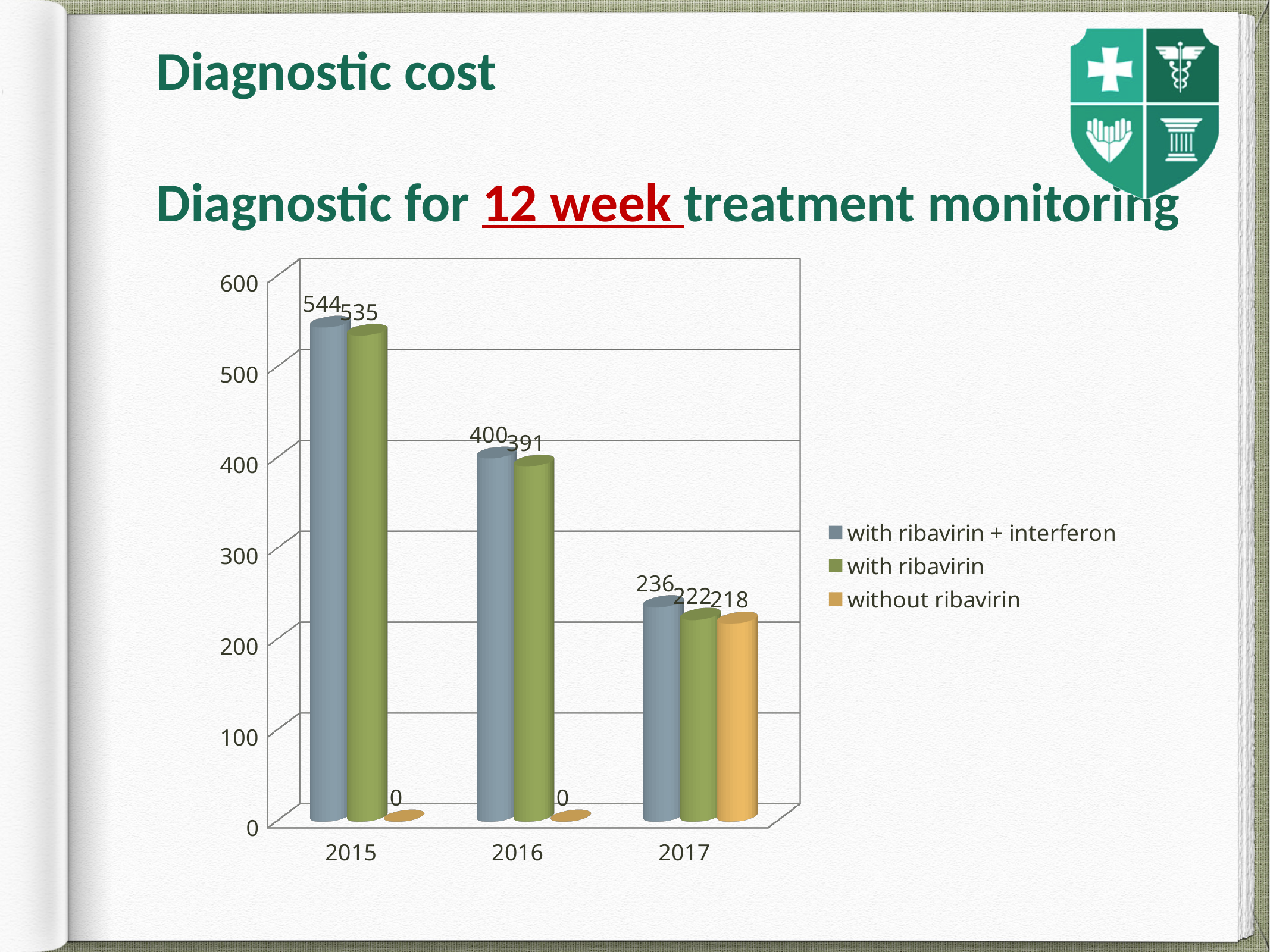
What is the value for 'with ribavirin' in 2016? 391 What is the value for 'without ribavirin' in 2015? 0 In which year is the value for 'with ribavirin' lowest? 2017 What is the difference between 'with ribavirin + interferon' and 'with ribavirin' in 2016? 9 How many series does the legend list? 3 How many years are shown on the x axis? 3 What kind of chart is shown on the slide? bar chart What is the value for 'with ribavirin + interferon' in 2015? 544 Do the values for 'with ribavirin' rise or fall from 2015 to 2017? fall Which is larger in 2017: 'with ribavirin + interferon' or 'without ribavirin'? with ribavirin + interferon What is the value for 'without ribavirin' in 2017? 218 In which year is the value for 'with ribavirin + interferon' highest? 2015